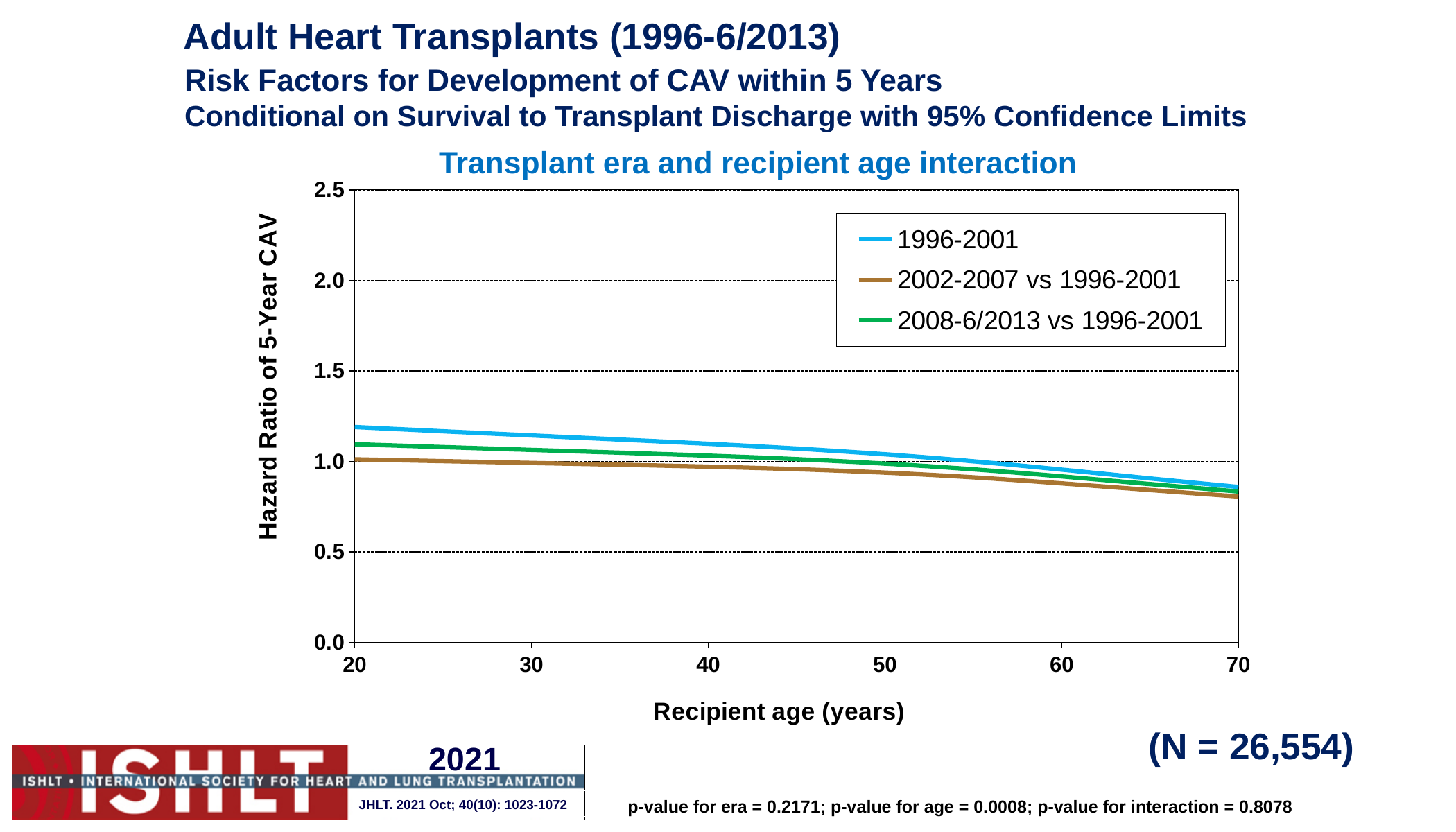
How many series does the legend list? 3 At recipient age 60, is the hazard ratio for the 2002-2007 vs 1996-2001 series greater or less than 1.0? less At recipient age 70, is the hazard ratio for the 2008-6/2013 vs 1996-2001 series greater or less than 1.0? less What kind of chart is shown on the slide? line chart Do the hazard ratios rise or fall as recipient age increases from 20 to 70? fall At recipient age 20, which is larger: the hazard ratio for 1996-2001 or for 2002-2007 vs 1996-2001? 1996-2001 Which series has the lowest hazard ratio at recipient age 20? 2002-2007 vs 1996-2001 At recipient age 20, is the hazard ratio for the 2008-6/2013 vs 1996-2001 series greater or less than 1.5? less What is the title of the chart? Transplant era and recipient age interaction Which series has the highest hazard ratio at recipient age 20? 1996-2001